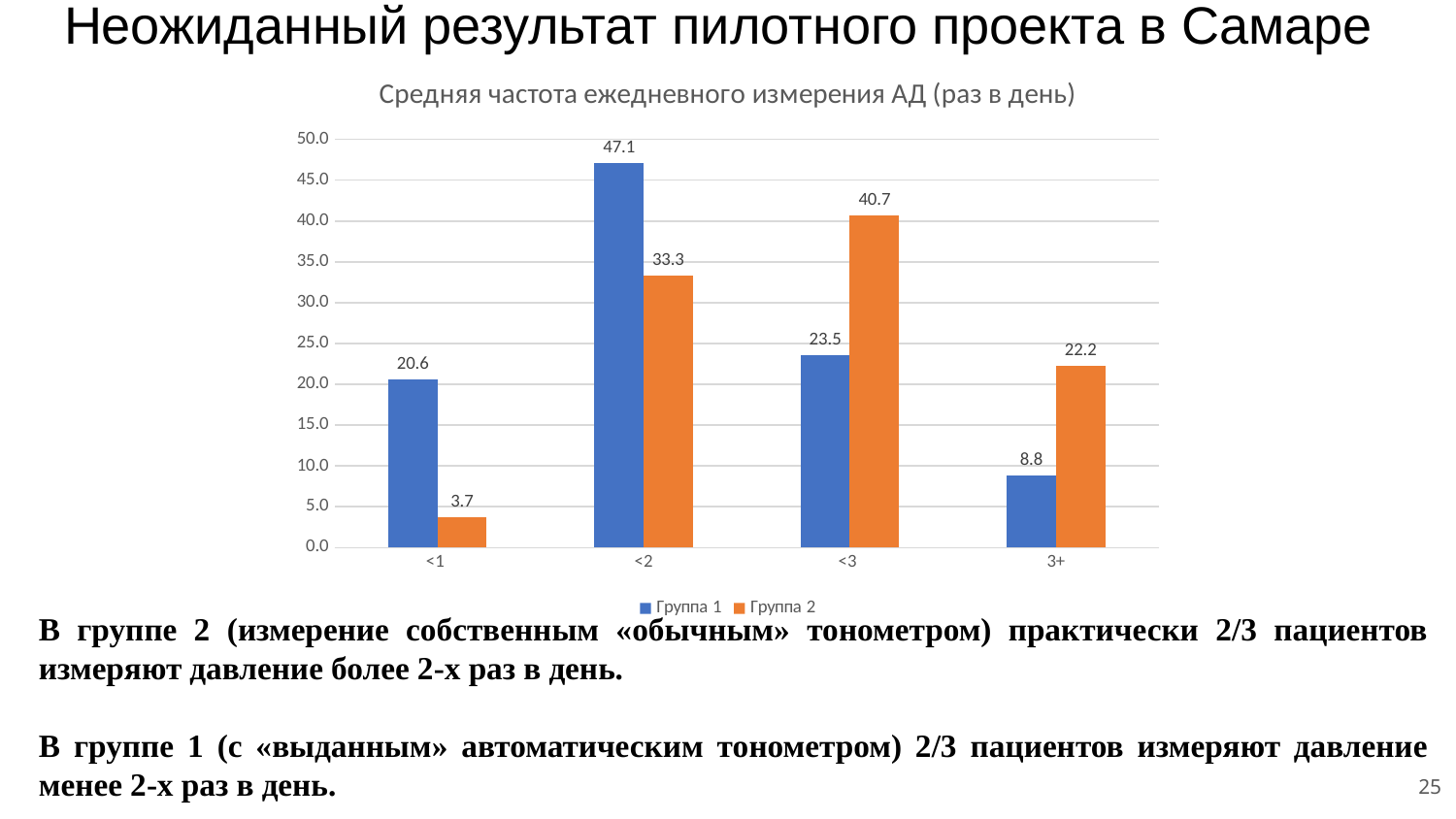
What is the value for Группа 1 in the <2 category? 47.1 What is the title of the chart? Средняя частота ежедневного измерения АД (раз в день) How many series does the legend list? 2 Which category has the highest value for Группа 1? <2 How many categories are shown on the x axis? 4 What is the value for Группа 2 in the <1 category? 3.7 What kind of chart is shown on the slide? Bar chart What is the difference between Группа 1 and Группа 2 in the <2 category? 13.8 What is the value for Группа 1 in the 3+ category? 8.8 What is the value for Группа 2 in the <3 category? 40.7 Which is larger in the <3 category, Группа 1 or Группа 2? Группа 2 Which category has the lowest value for Группа 2? <1